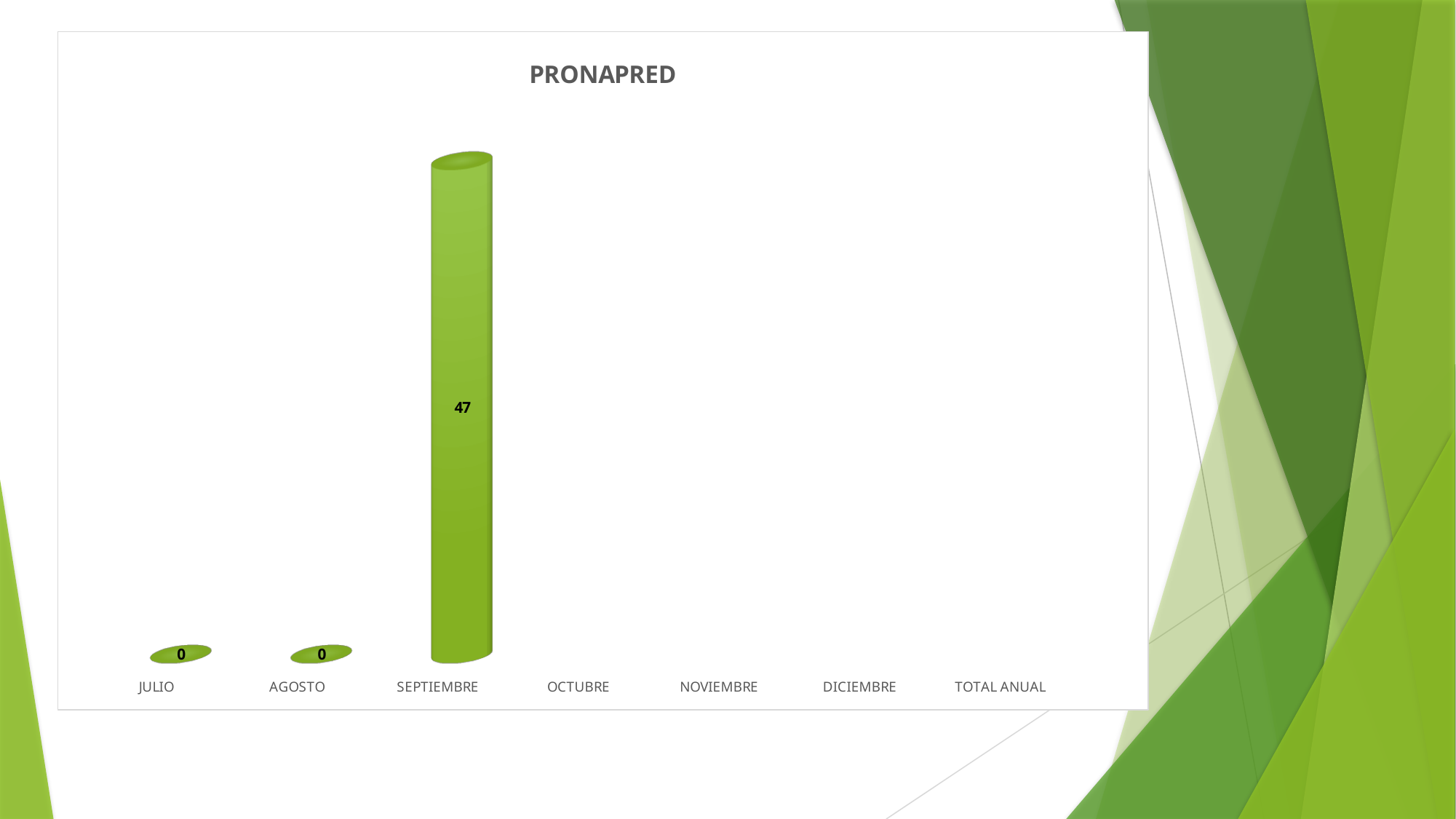
What is the value for SEPTIEMBRE? 47 Which category has the highest value? SEPTIEMBRE What is the value for AGOSTO? 0 How many categories are shown on the x axis? 7 What kind of chart is shown on the slide? bar chart What is the value for JULIO? 0 What is the label of the last category on the x axis? TOTAL ANUAL Which is larger, the value for SEPTIEMBRE or the value for JULIO? SEPTIEMBRE What is the difference between the values for SEPTIEMBRE and AGOSTO? 47 What is the title of the chart? PRONAPRED